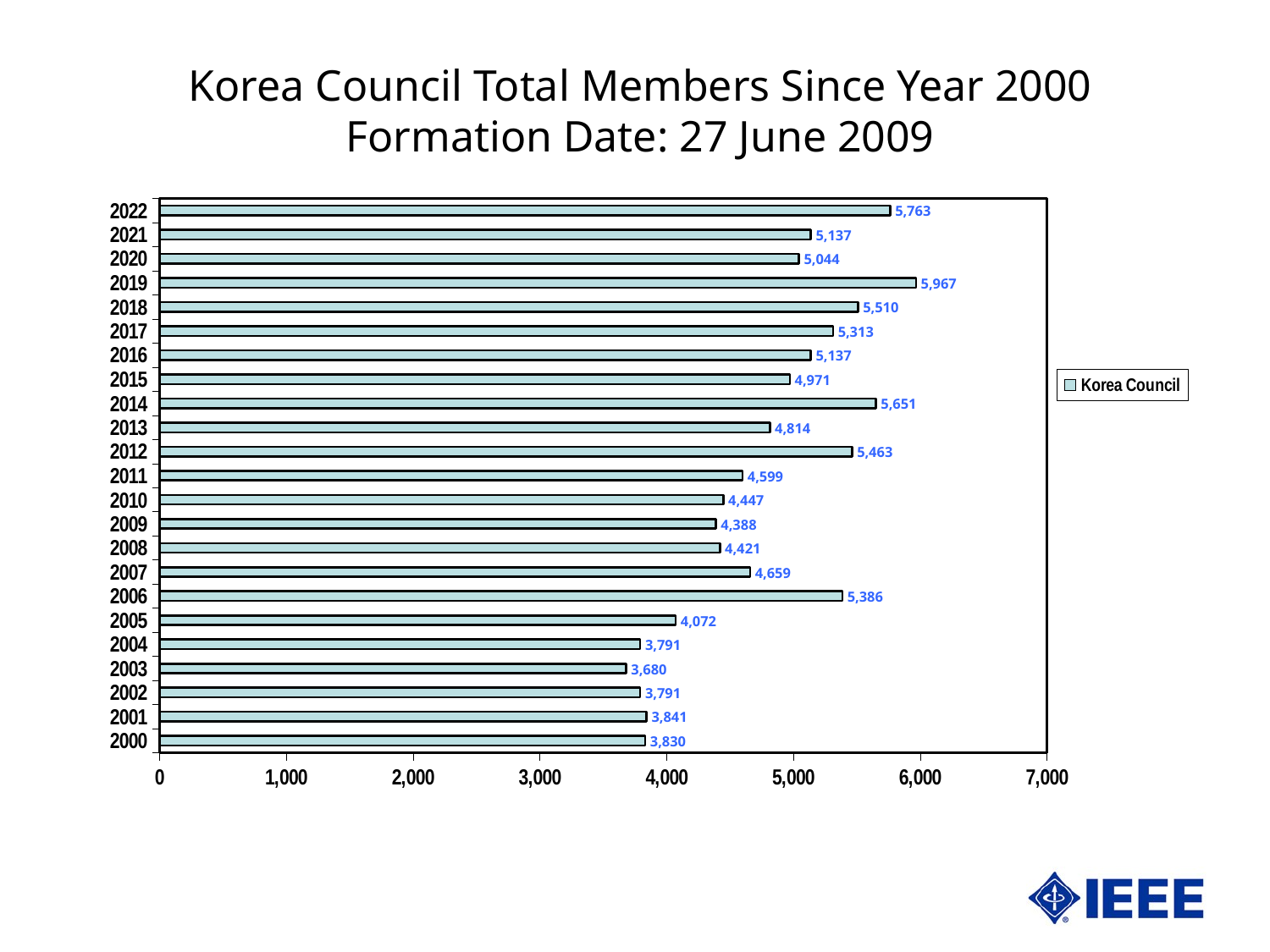
What is the value for 2006? 5,386 What is the difference between the values for 2022 and 2021? 626 How many years are shown on the chart? 23 What is the legend entry for the series? Korea Council Which is larger, the value for 2014 or the value for 2015? 2014 What kind of chart is shown? bar chart Which year has the highest value? 2019 What is the value for 2022? 5,763 What is the value for 2000? 3,830 How many series does the legend list? 1 Is the value for 2019 greater or less than 5,000? greater Which year has the lowest value? 2003